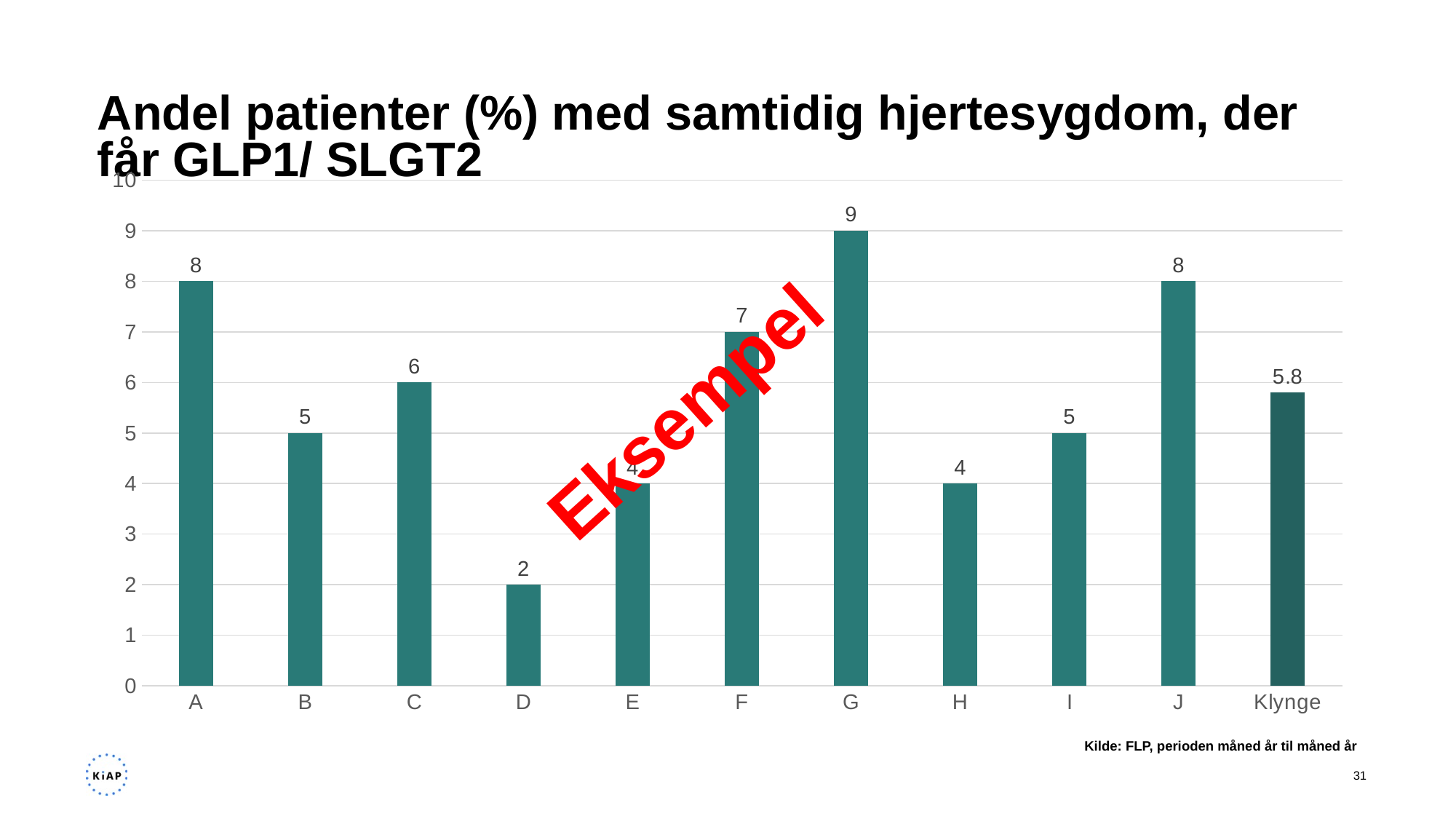
What is the value for category J? 8 What is the value for category G? 9 How many categories are shown on the x axis? 11 What is the difference between the values for G and D? 7 What is the value for category D? 2 Which category has the highest value? G What is the source text shown below the chart? Kilde: FLP, perioden måned år til måned år Is the value for F greater or less than 5? greater Which is larger, the value for C or the value for H? C What kind of chart is shown on the slide? Bar chart Which category has the lowest value? D What is the value for Klynge? 5.8